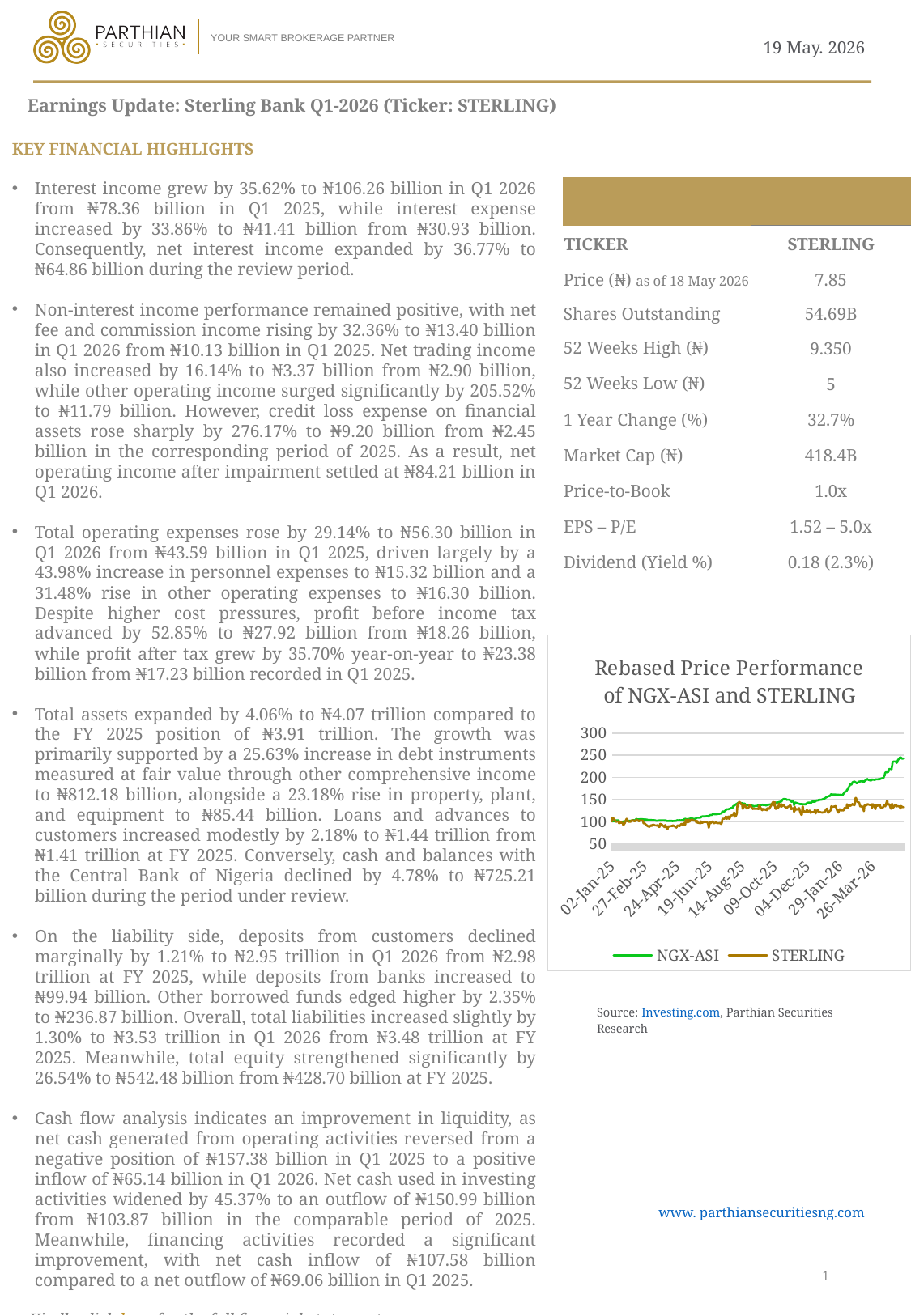
Does the NGX-ASI line rise or fall overall from 02-Jan-25 to 26-Mar-26? rise Around 02-Jan-25, is the NGX-ASI value greater or less than 150? less Which colour is used for the NGX-ASI line in the chart? green How many series does the legend of the chart list? 2 What kind of chart is shown on the slide? line chart What is the title of the chart on the slide? Rebased Price Performance of NGX-ASI and STERLING How many date labels are shown on the x axis of the chart? 9 Around 14-Aug-25, is the STERLING value greater or less than 100? greater What is the highest tick value shown on the y axis of the chart? 300 At the end of the chart (around 26-Mar-26), which series is higher, NGX-ASI or STERLING? NGX-ASI At the end of the chart (around 26-Mar-26), is the STERLING value greater or less than 200? less